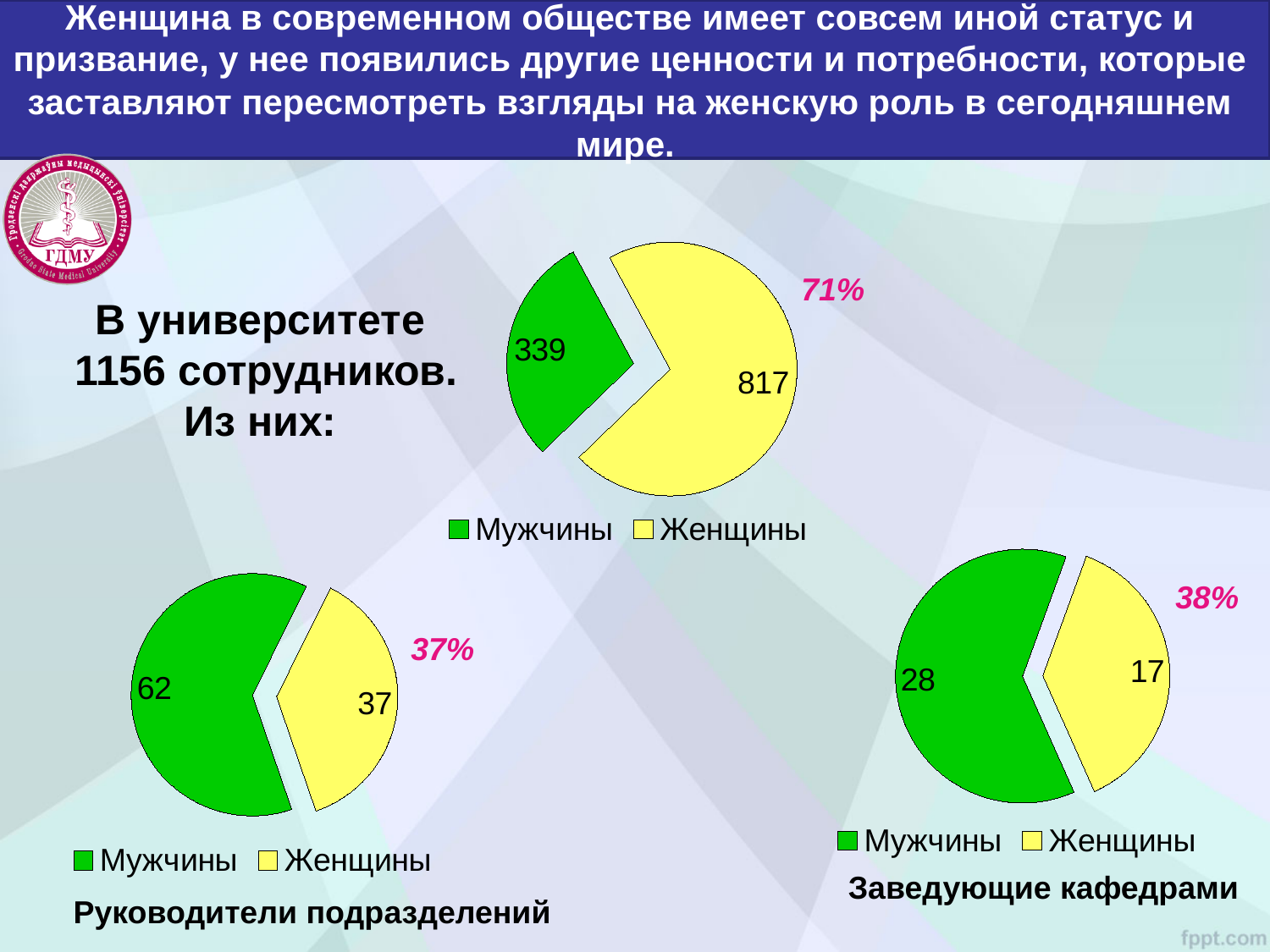
In the top pie chart, what is the value for Мужчины? 339 In the bottom-left pie chart (Руководители подразделений), what is the value for Женщины? 37 In the top pie chart, what is the value for Женщины? 817 What type of chart is used for the three charts on the slide? Pie chart In the bottom-right pie chart (Заведующие кафедрами), what is the value for Женщины? 17 In the top pie chart, what is the difference between the values for Женщины and Мужчины? 478 In the bottom-right pie chart (Заведующие кафедрами), what is the value for Мужчины? 28 In the top pie chart, which category has the larger value, Мужчины or Женщины? Женщины In the bottom-left pie chart (Руководители подразделений), which category is the largest? Мужчины In the bottom-left pie chart (Руководители подразделений), what is the value for Мужчины? 62 In the bottom-right pie chart (Заведующие кафедрами), what is the difference between the values for Мужчины and Женщины? 11 In the top pie chart, what percentage is printed next to the Женщины slice? 71%